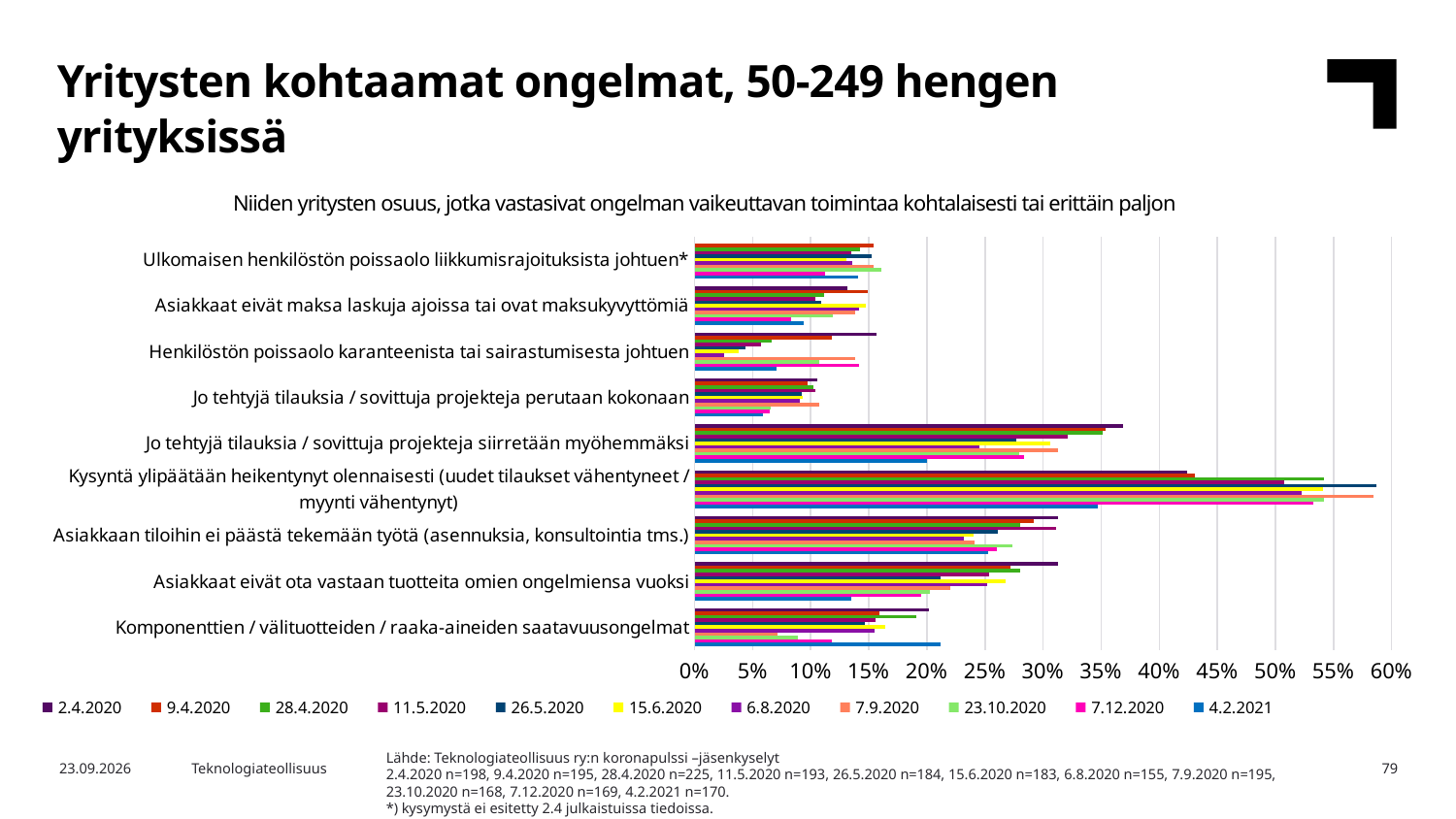
What is the first survey date listed in the legend? 2.4.2020 What kind of chart is shown on the slide? Bar chart How many problem categories are listed on the chart's vertical axis? 9 Is the value for 'Asiakkaat eivät ota vastaan tuotteita omien ongelmiensa vuoksi' on 2.4.2020 greater or less than 25%? greater For the 2.4.2020 series, which is larger: 'Kysyntä ylipäätään heikentynyt olennaisesti' or 'Jo tehtyjä tilauksia / sovittuja projekteja siirretään myöhemmäksi'? Kysyntä ylipäätään heikentynyt olennaisesti Which category has the highest values across the survey dates? Kysyntä ylipäätään heikentynyt olennaisesti (uudet tilaukset vähentyneet / myynti vähentynyt) How many survey dates (series) does the legend list? 11 Is the value for 'Kysyntä ylipäätään heikentynyt olennaisesti' on 26.5.2020 greater or less than 55%? greater For 'Komponenttien / välituotteiden / raaka-aineiden saatavuusongelmat', which is larger: the 2.4.2020 value or the 4.2.2021 value? 4.2.2021 Is the value for 'Kysyntä ylipäätään heikentynyt olennaisesti' on 4.2.2021 greater or less than 30%? greater What is the maximum value shown on the horizontal axis? 60%